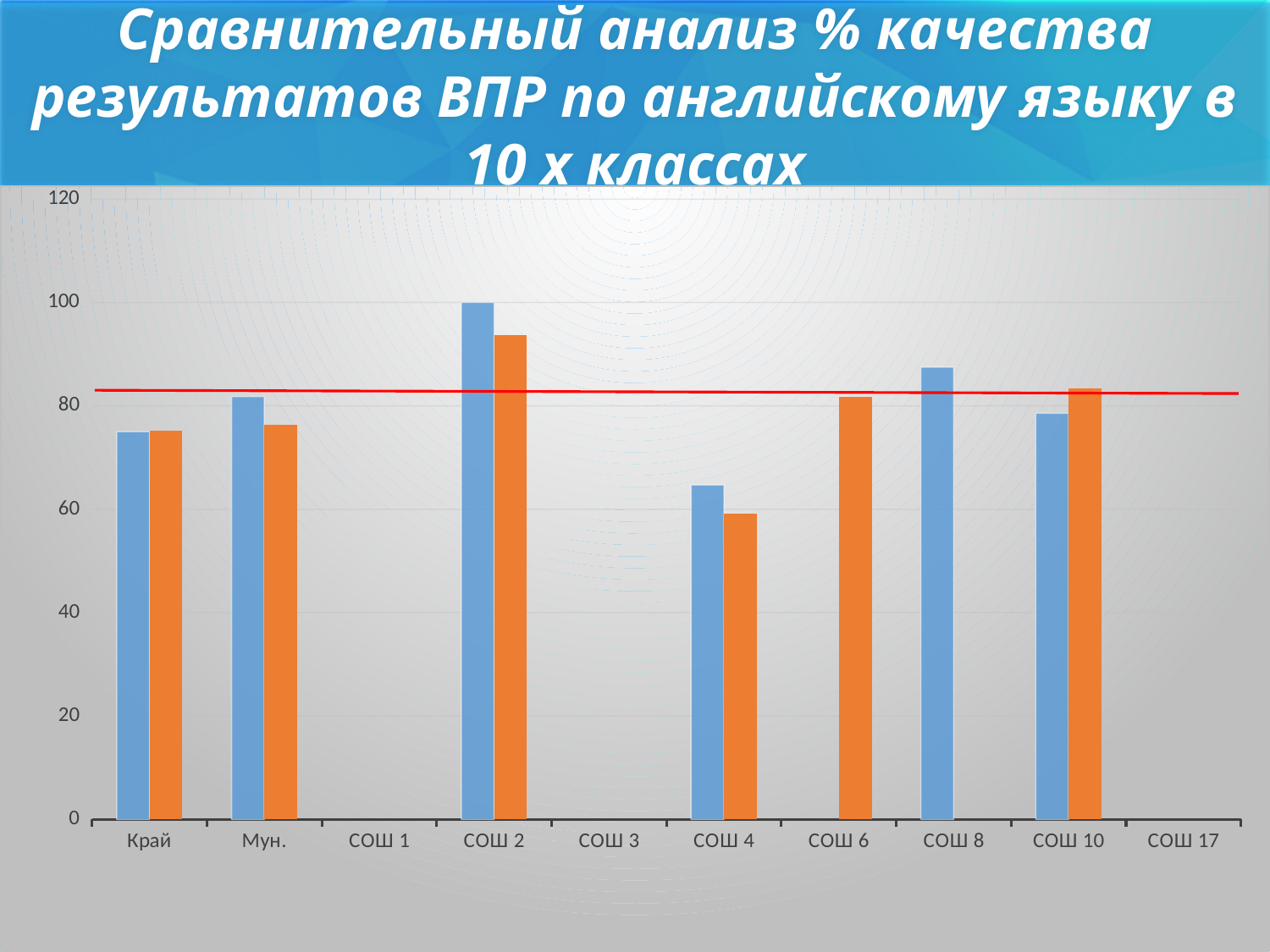
Is the value of the blue bar for СОШ 4 greater or less than 80? less Which categories on the x axis have no bars at all? СОШ 1, СОШ 3, СОШ 17 What kind of chart is shown on the slide? bar chart What is the value of the blue bar for СОШ 2? 100 Is the value of the blue bar for СОШ 8 greater or less than 80? greater How many categories are shown on the x axis? 10 Is the value of the orange bar for СОШ 2 greater or less than 80? greater Which category has the shortest blue bar among those with a blue bar? СОШ 4 For СОШ 4, which bar is taller, the blue one or the orange one? blue Which category has the tallest blue bar? СОШ 2 What is the highest value shown on the vertical axis? 120